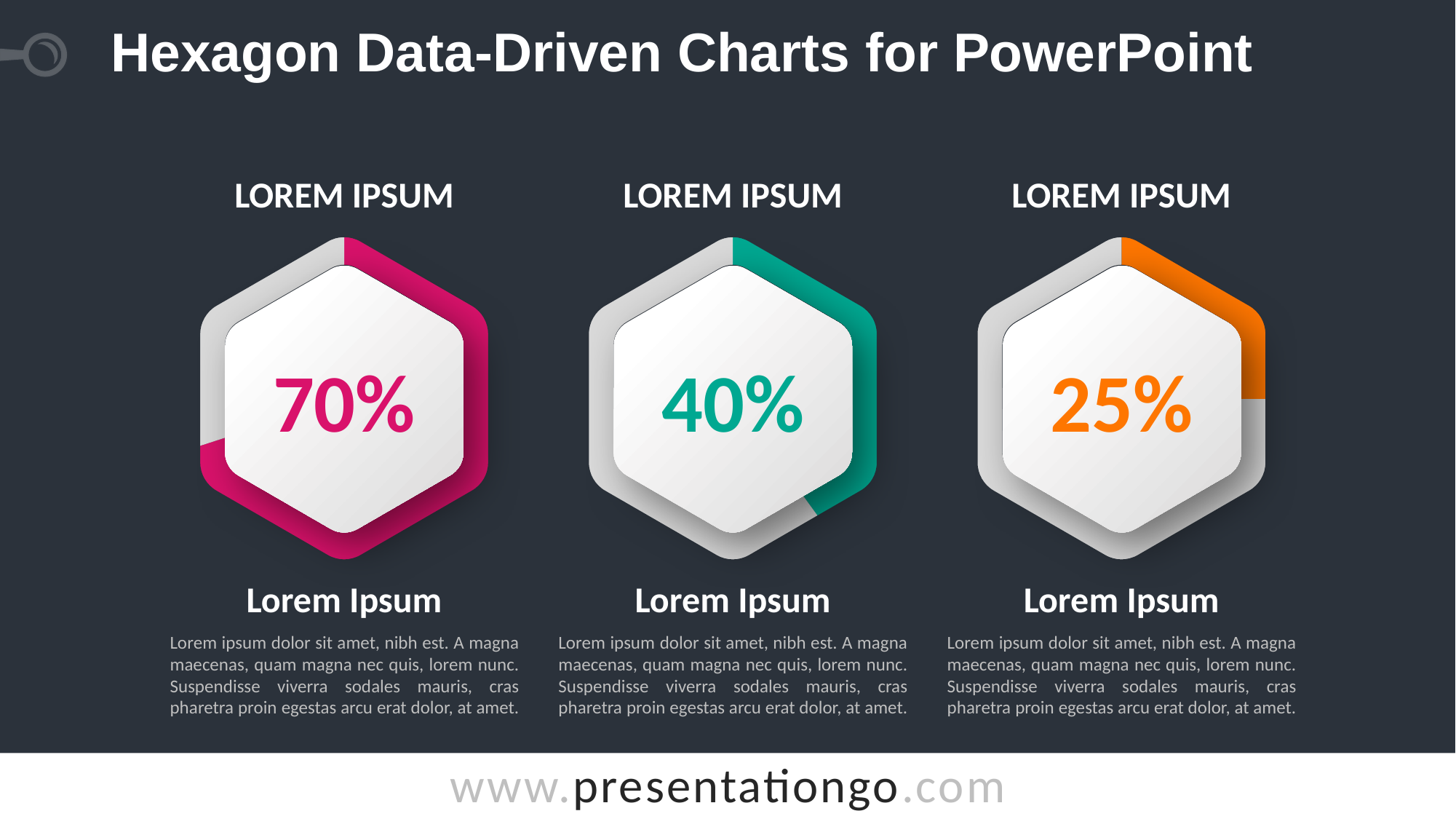
What is the difference between the value in the middle hexagon chart and the value in the right hexagon chart? 15% Which of the three hexagon charts shows the lowest value? The right chart (25%) Which is larger, the value in the middle hexagon chart or the value in the right hexagon chart? The middle chart (40%) What colour is the filled portion of the left hexagon chart? Pink (magenta) What value is shown in the middle hexagon chart? 40% What colour is the filled portion of the right hexagon chart? Orange Which of the three hexagon charts shows the highest value? The left chart (70%) How many hexagon charts are on the slide? 3 What value is shown in the left hexagon chart? 70% Do the values decrease or increase from the left chart to the right chart? Decrease What is the difference between the value in the left hexagon chart and the value in the middle hexagon chart? 30% What value is shown in the right hexagon chart? 25%